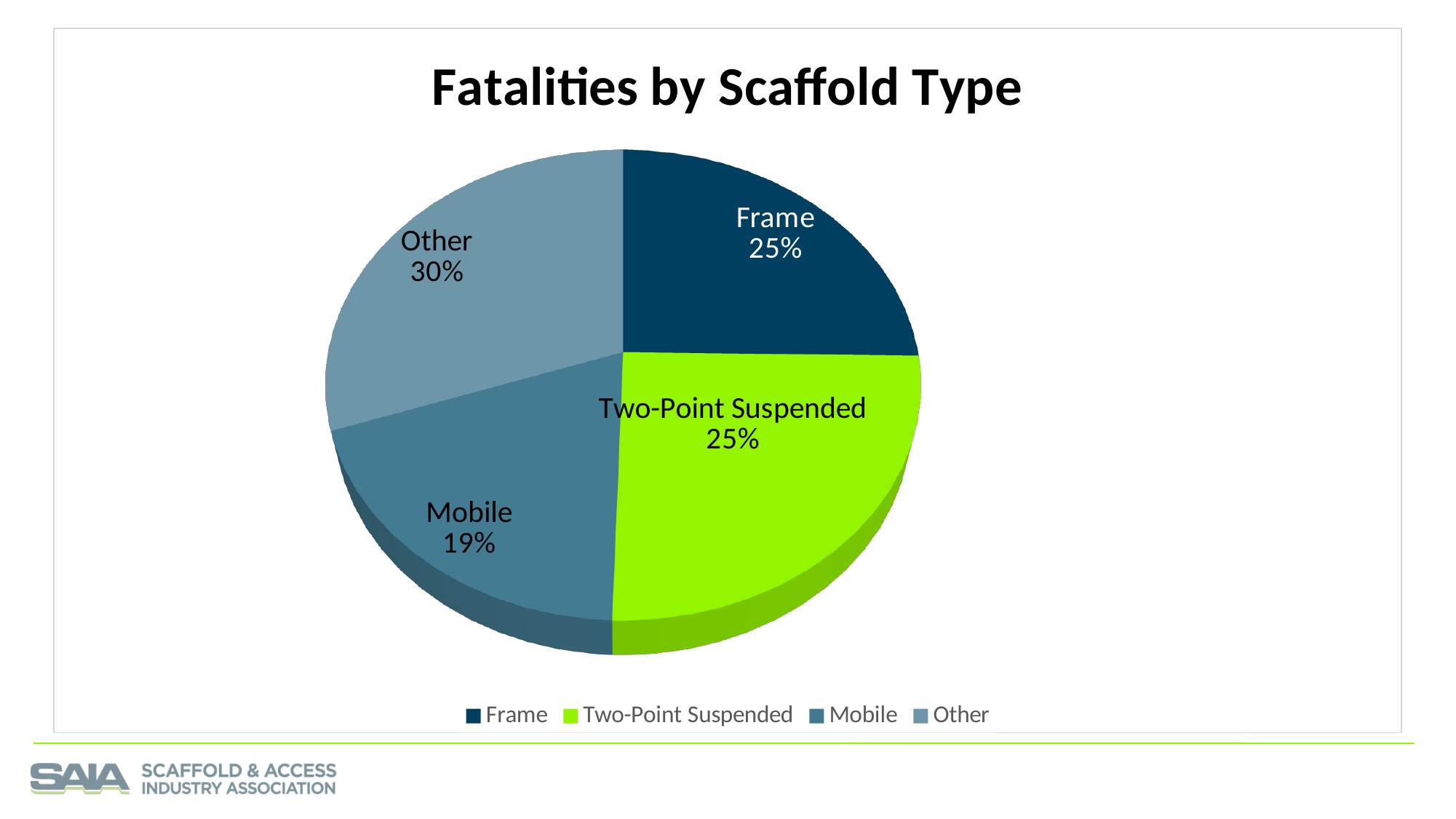
What share of fatalities is attributed to Other scaffold types? 30% Which scaffold type has the smallest share of fatalities? Mobile What share of fatalities is attributed to Two-Point Suspended scaffolds? 25% What is the title of the chart? Fatalities by Scaffold Type What kind of chart is shown on the slide? Pie chart How many scaffold types are shown in the pie chart? 4 What share of fatalities is attributed to Mobile scaffolds? 19% Which is larger, the share for Frame or the share for Mobile? Frame How many entries does the legend list? 4 Which scaffold type has the largest share of fatalities? Other What is the difference in percentage points between the Other and Mobile slices? 11